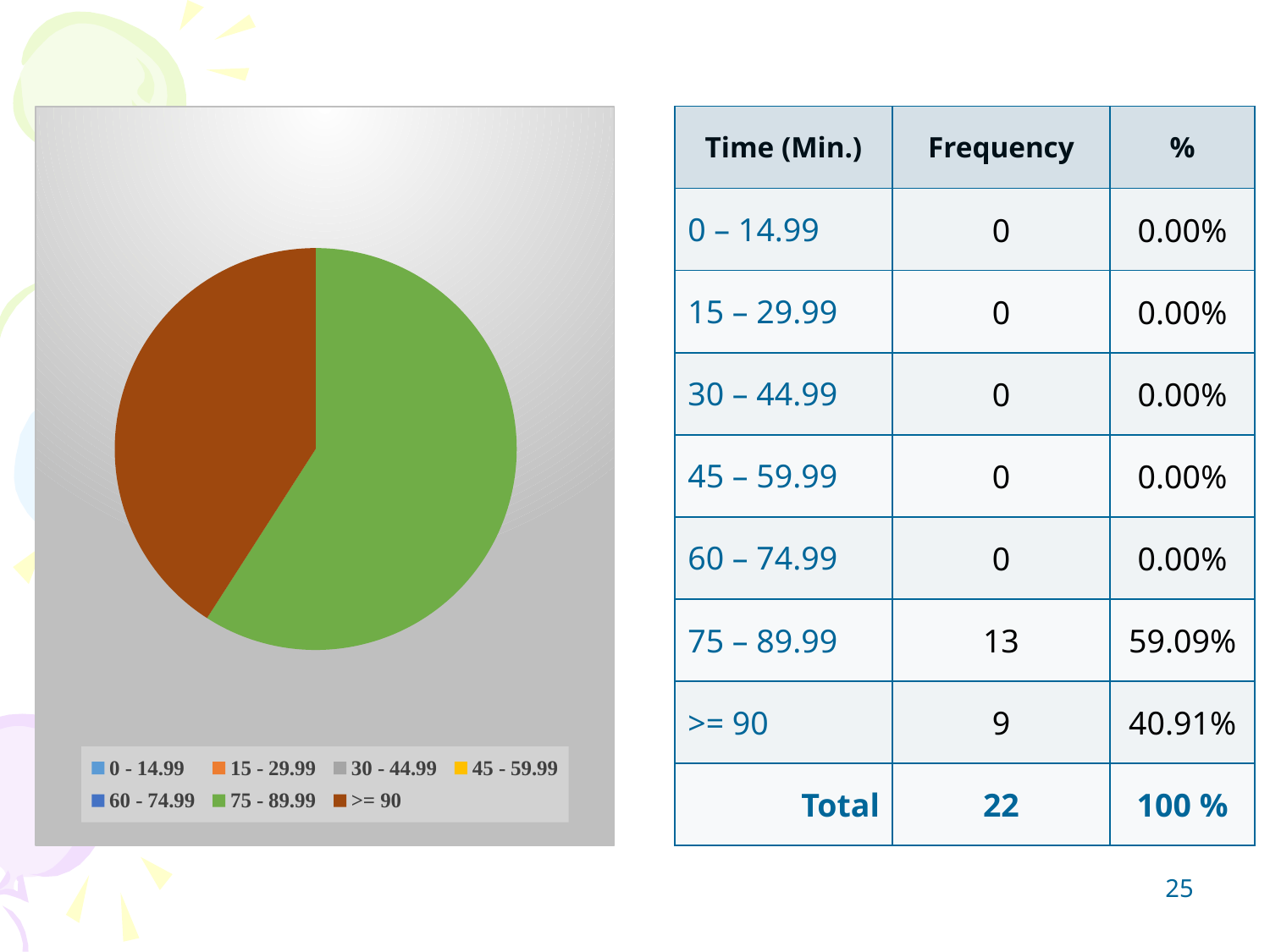
What colour is the >= 90 slice in the pie chart? brown According to the table, what is the frequency for the 75 – 89.99 category? 13 Which category has the largest slice in the pie chart? 75 - 89.99 According to the table, what percentage share does the 75 – 89.99 slice have? 59.09% How many categories does the pie chart's legend list? 7 How many categories in the table have a frequency of 0? 5 What is the total frequency shown in the table? 22 What kind of chart is shown on the left of the slide? pie chart According to the table, what is the frequency for the >= 90 category? 9 Which of the two visible slices is larger, 75 - 89.99 or >= 90? 75 - 89.99 What is the difference in frequency between the 75 – 89.99 and >= 90 categories? 4 According to the table, what percentage share does the >= 90 slice have? 40.91%